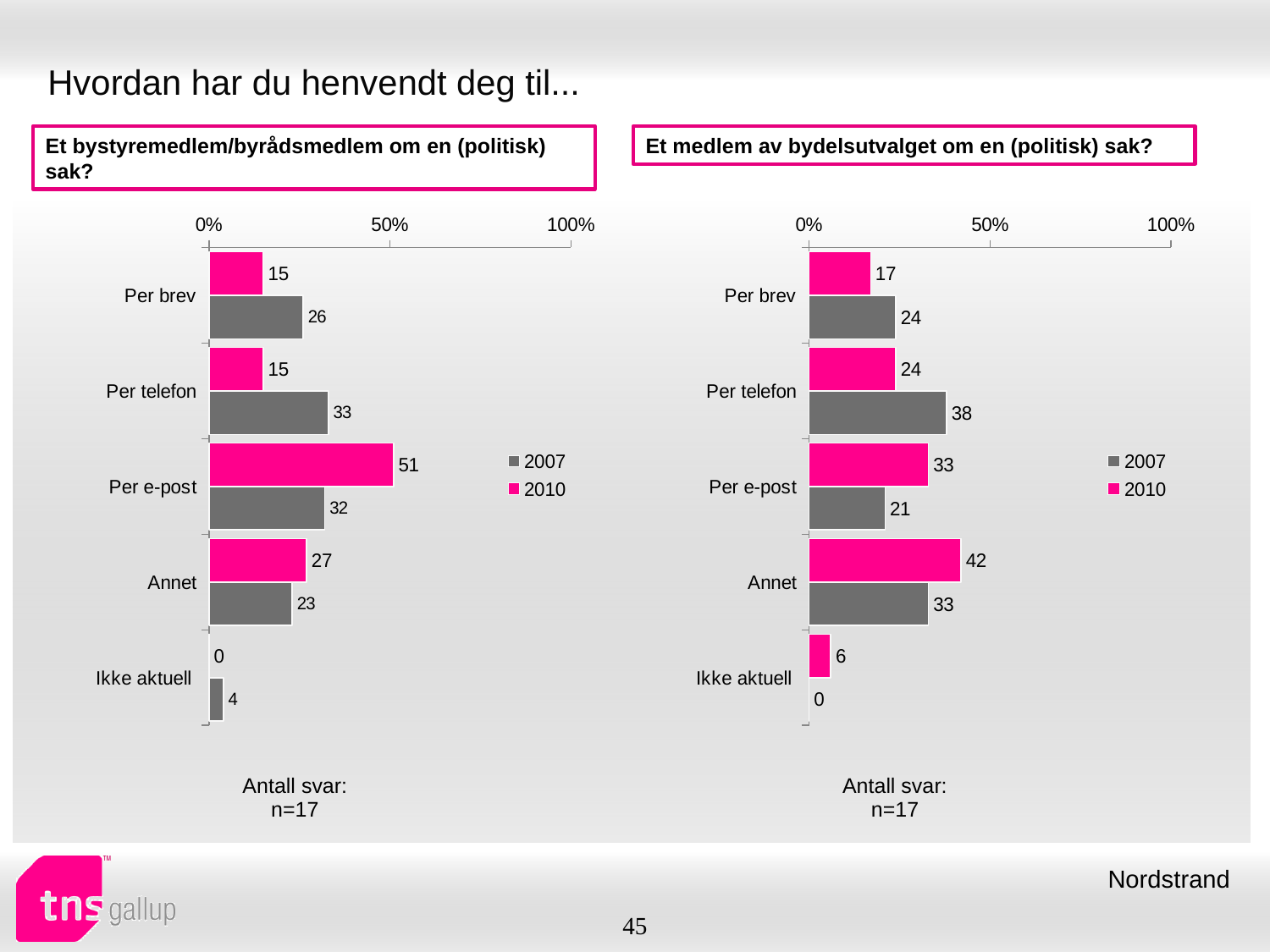
In the left chart, which category has the highest 2010 value? Per e-post In the right chart, what is the difference between the 2010 and 2007 values for Annet? 9 How many categories are shown in the right chart? 5 How many series does the legend of the left chart list? 2 In the right chart, which category has the lowest 2007 value? Ikke aktuell In the left chart, what is the difference between the 2010 and 2007 values for Per e-post? 19 In the right chart (Et medlem av bydelsutvalget om en (politisk) sak?), what is the 2007 value for Per telefon? 38 What kind of chart is the left chart? Bar chart In the right chart, what is the 2010 value for Ikke aktuell? 6 In the left chart, which is larger for Per telefon: the 2007 value or the 2010 value? 2007 In the right chart, which is larger for Per e-post: the 2007 value or the 2010 value? 2010 In the left chart (Et bystyremedlem/byrådsmedlem om en (politisk) sak?), what is the 2010 value for Per e-post? 51